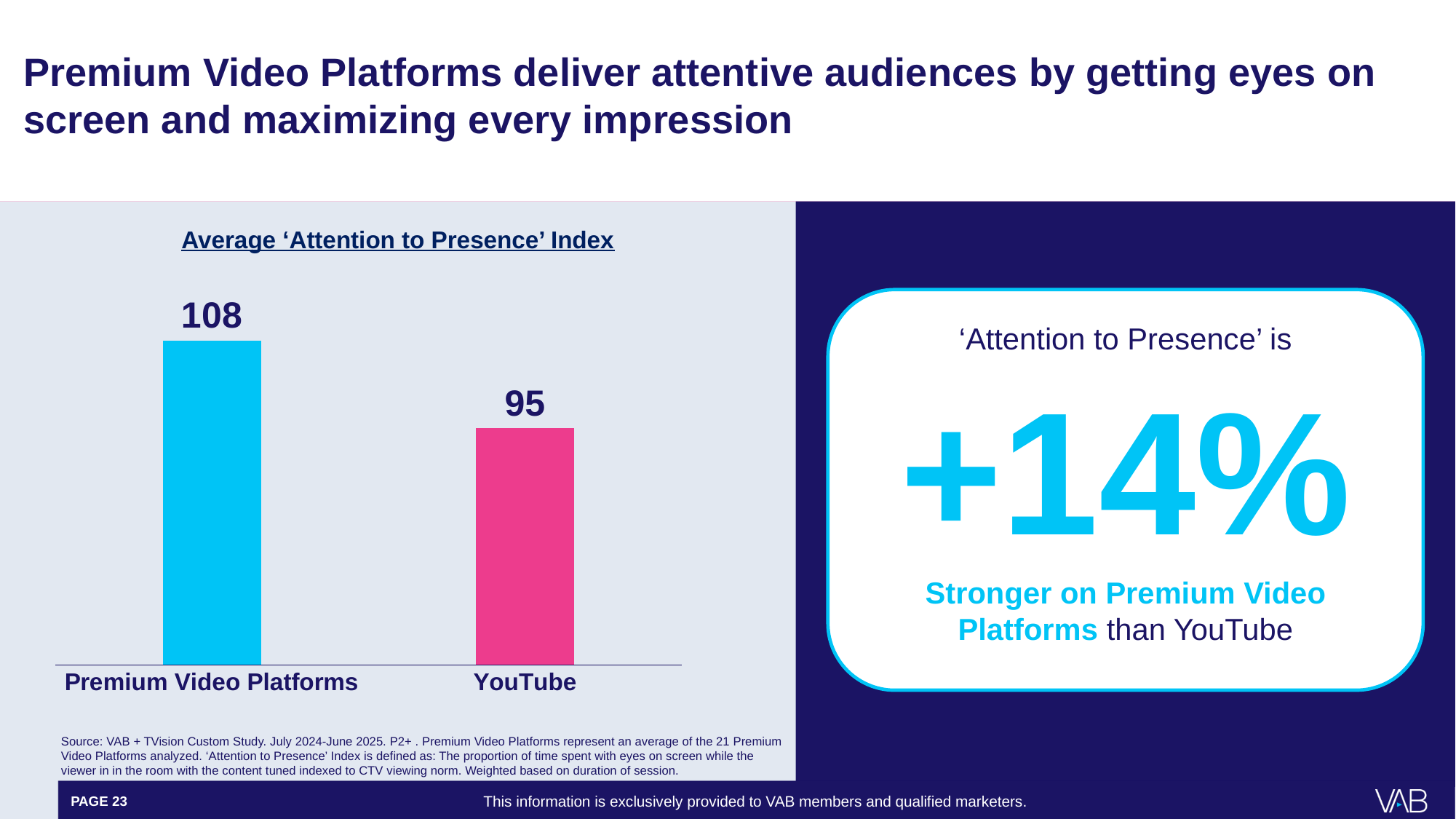
Which category has the highest Average 'Attention to Presence' Index? Premium Video Platforms What is the Average 'Attention to Presence' Index value for Premium Video Platforms? 108 Which category has the lowest Average 'Attention to Presence' Index? YouTube How many categories are shown in the Average 'Attention to Presence' Index chart? 2 What is the difference between the Average 'Attention to Presence' Index for Premium Video Platforms and YouTube? 13 According to the callout on the slide, by what percentage is 'Attention to Presence' stronger on Premium Video Platforms than YouTube? +14% What is the title of the chart on the slide? Average 'Attention to Presence' Index What is the Average 'Attention to Presence' Index value for YouTube? 95 What colour is the bar for YouTube in the chart? Pink Which has a larger Average 'Attention to Presence' Index, Premium Video Platforms or YouTube? Premium Video Platforms What kind of chart is used to show the Average 'Attention to Presence' Index? Bar chart